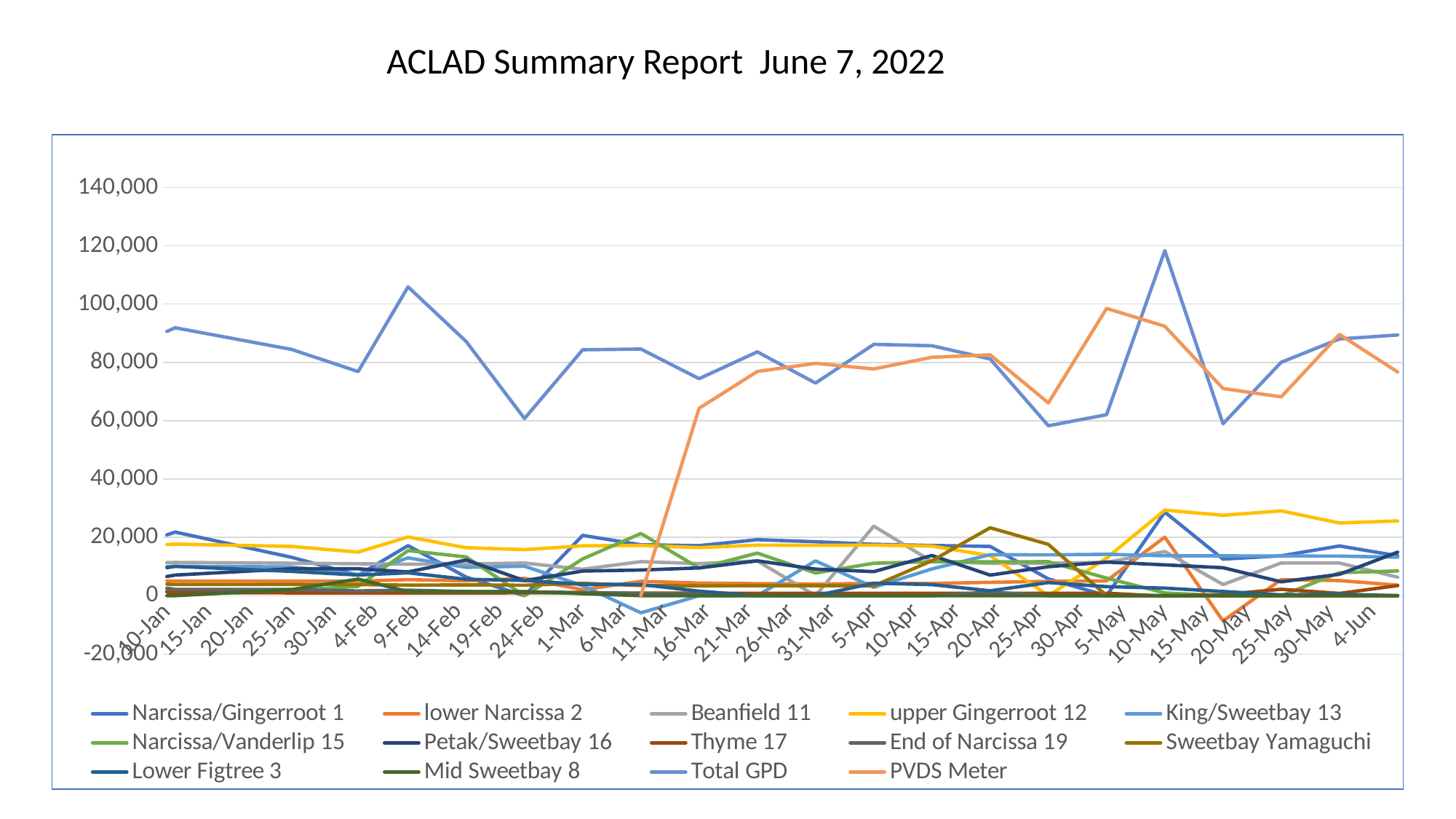
On which date does the Total GPD series reach its highest value? 10-May How many dates are shown along the x axis of the chart? 30 What is the title shown above the chart? ACLAD Summary Report June 7, 2022 Is the Total GPD value on 9-Feb greater or less than 100,000? greater Is the PVDS Meter value on 5-May greater or less than 80,000? greater On 10-May, which is larger: the Total GPD value or the PVDS Meter value? Total GPD Does the PVDS Meter series rise or fall between 11-Mar and 16-Mar? rise Is the Total GPD value on 24-Feb greater or less than 80,000? less What kind of chart is shown on the slide? line chart How many series does the chart legend list? 14 On 5-May, which is larger: the PVDS Meter value or the Total GPD value? PVDS Meter